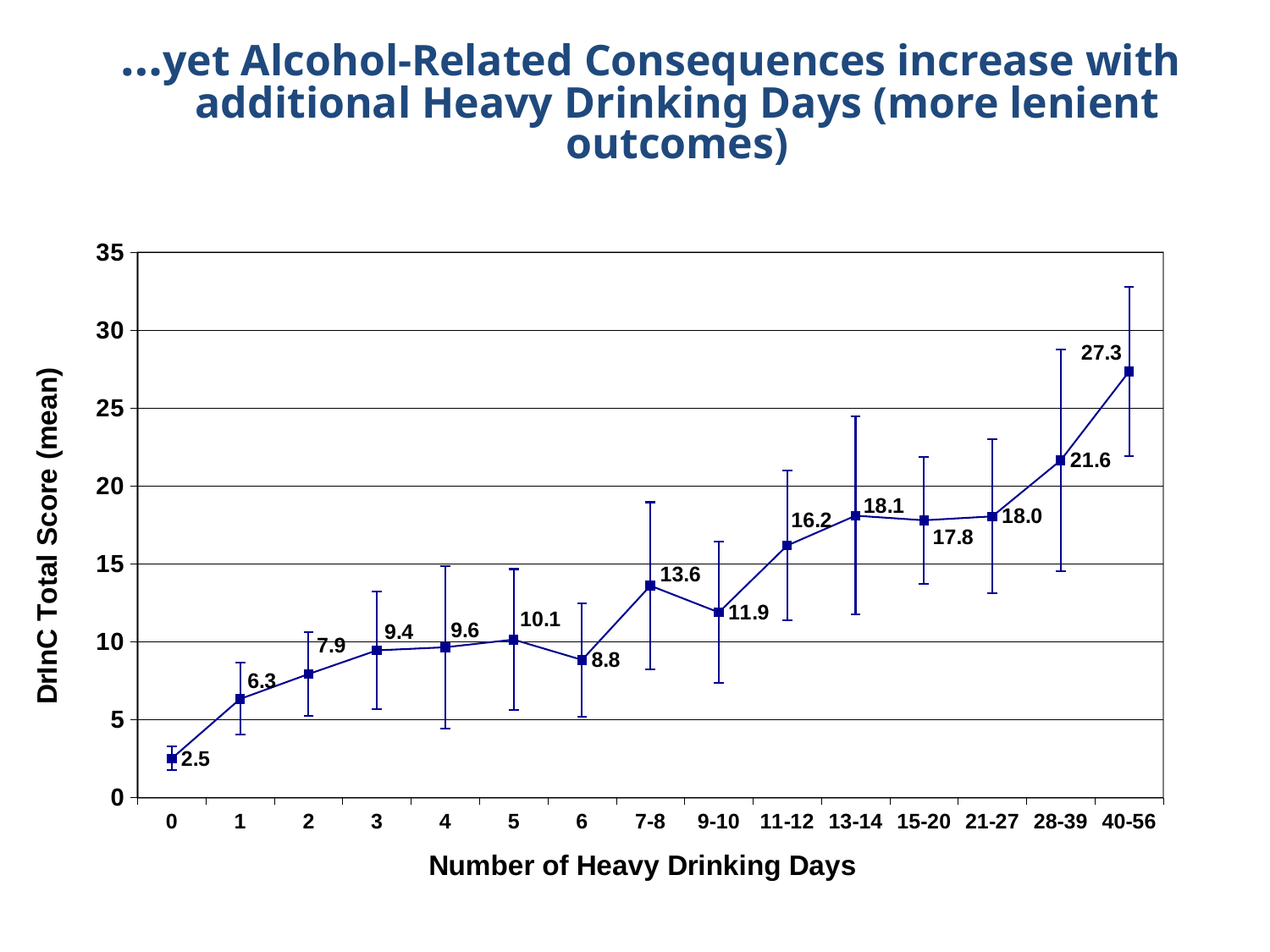
What is the label of the y axis? DrInC Total Score (mean) What is the mean DrInC Total Score for the 40-56 heavy drinking days category? 27.3 What is the label of the x axis? Number of Heavy Drinking Days Which category of heavy drinking days has the highest mean DrInC Total Score? 40-56 What is the difference in mean DrInC Total Score between the 40-56 and 28-39 heavy drinking days categories? 5.7 Which has a higher mean DrInC Total Score: 7-8 heavy drinking days or 9-10 heavy drinking days? 7-8 What kind of chart is shown on the slide? Line chart Which category of heavy drinking days has the lowest mean DrInC Total Score? 0 Do the mean DrInC Total Scores generally rise or fall as the number of heavy drinking days increases? Rise How many categories of heavy drinking days are shown on the x axis? 15 What is the mean DrInC Total Score for 0 heavy drinking days? 2.5 What is the mean DrInC Total Score for the 9-10 heavy drinking days category? 11.9